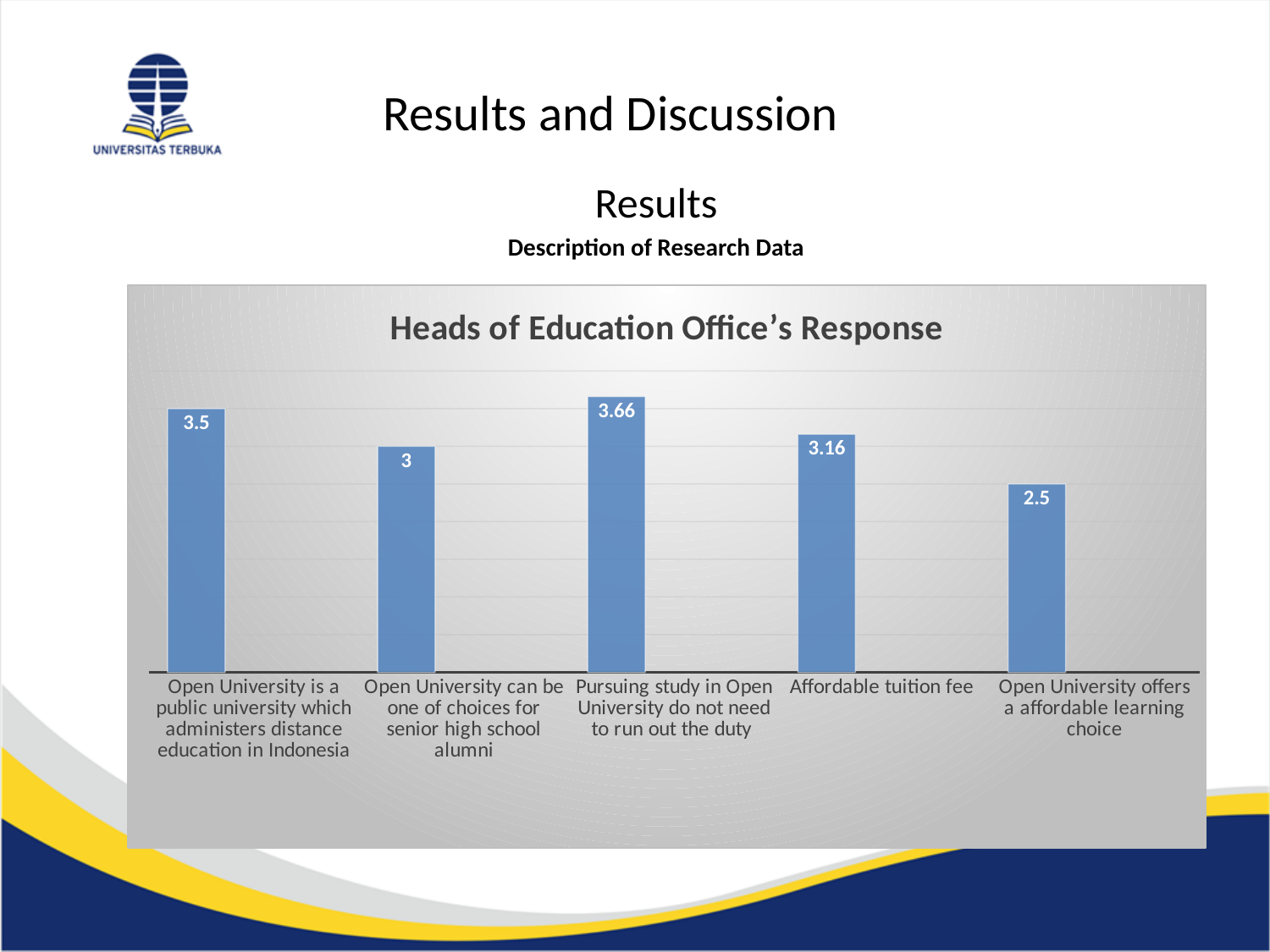
What is the value for "Open University can be one of choices for senior high school alumni"? 3 Which category has the highest value? Pursuing study in Open University do not need to run out the duty How many categories are shown in the chart? 5 Which category has the lowest value? Open University offers a affordable learning choice What kind of chart is shown on the slide? Bar chart What is the difference between the value for "Pursuing study in Open University do not need to run out the duty" and the value for "Affordable tuition fee"? 0.5 What is the title of the chart? Heads of Education Office's Response What is the value for "Affordable tuition fee"? 3.16 What is the value for "Open University offers a affordable learning choice"? 2.5 Which is larger: the value for "Open University is a public university which administers distance education in Indonesia" or the value for "Affordable tuition fee"? Open University is a public university which administers distance education in Indonesia What is the difference between the value for "Open University is a public university which administers distance education in Indonesia" and the value for "Open University offers a affordable learning choice"? 1 What colour are the bars in the chart? Blue